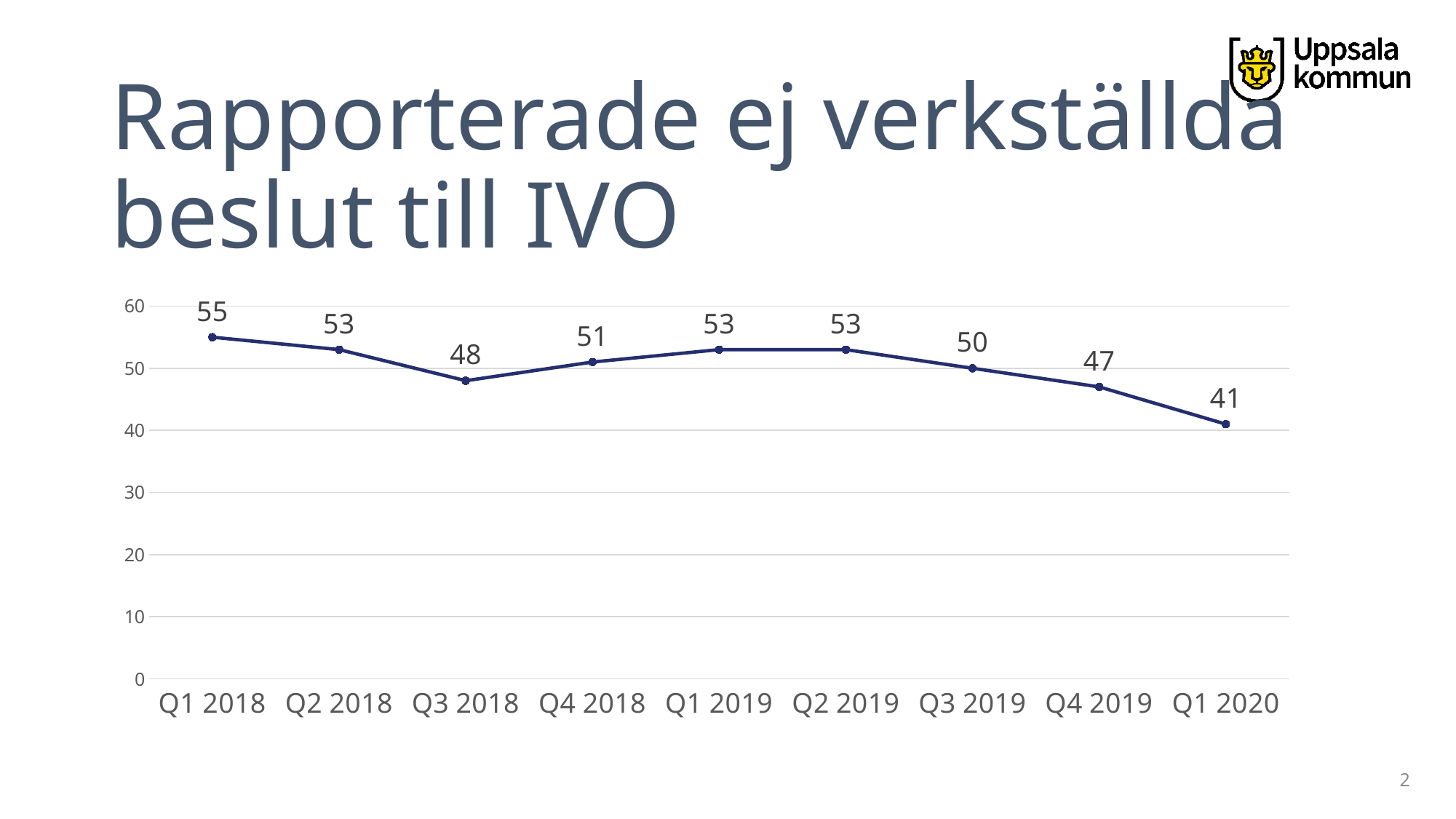
Which quarter has the lowest value? Q1 2020 What is the value for Q1 2020? 41 Which quarter has the highest value? Q1 2018 Do the values generally rise or fall from Q1 2018 to Q1 2020? fall What is the difference between the values for Q1 2018 and Q1 2020? 14 How many quarters are plotted on the chart? 9 What is the value for Q4 2019? 47 What is the value for Q1 2018? 55 Which is larger, the value for Q4 2018 or the value for Q3 2019? Q4 2018 What kind of chart is shown on the slide? line chart What is the value for Q3 2018? 48 Is the value for Q2 2019 greater or less than 50? greater